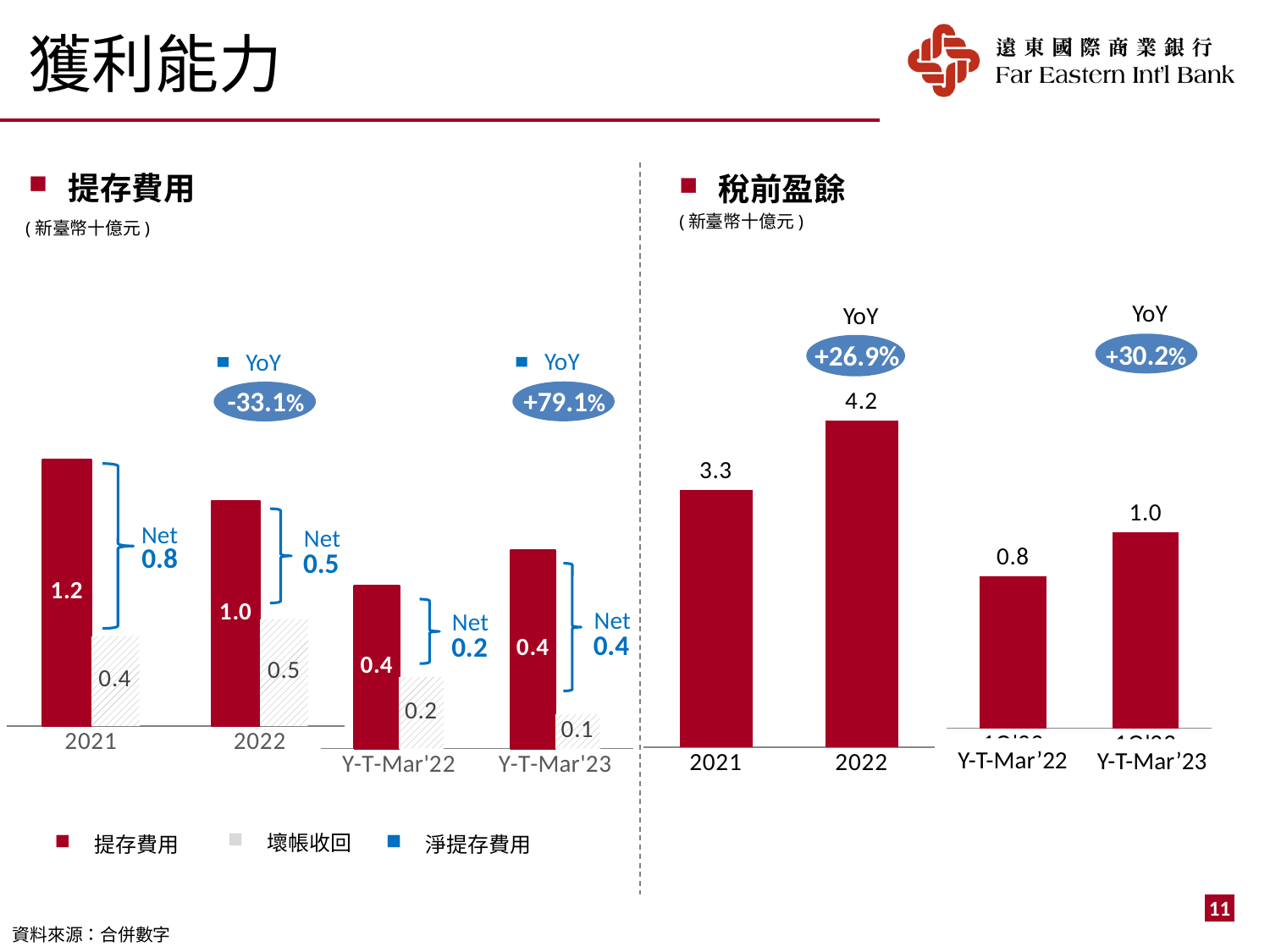
In the 提存費用 chart, what is the 壞帳收回 value for 2022? 0.5 In the 稅前盈餘 chart, what YoY change is shown for Y-T-Mar'23? +30.2% In the 稅前盈餘 chart, what is the value for Y-T-Mar'23? 1.0 In the 提存費用 chart, what is the 提存費用 value for 2021? 1.2 How many series does the legend of the 提存費用 chart list? 3 In the 提存費用 chart, what is the Net value for Y-T-Mar'23? 0.4 In the 稅前盈餘 chart, which period has the highest value? 2022 In the 稅前盈餘 chart, what is the difference between the 2022 and 2021 values? 0.9 In the 提存費用 chart, is the 提存費用 value for 2021 larger or smaller than the value for 2022? larger In the 稅前盈餘 chart, what is the value for 2022? 4.2 In the 稅前盈餘 chart, which period has the lowest value? Y-T-Mar'22 In the 提存費用 chart, what YoY change is shown for 2022? -33.1%